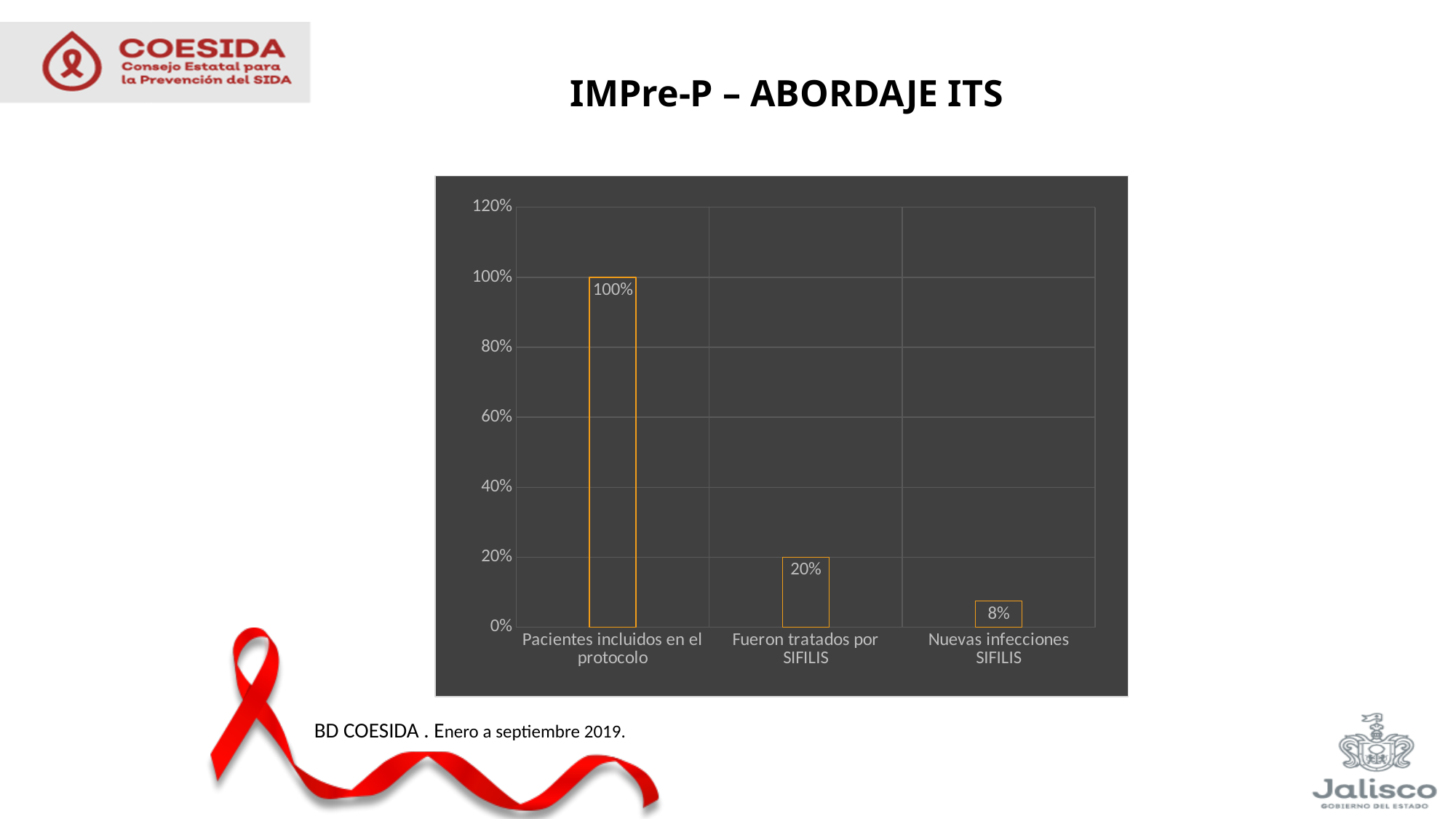
How many categories are shown on the x axis of the chart? 3 What is the value for "Nuevas infecciones SIFILIS"? 8% Which category has the highest value? Pacientes incluidos en el protocolo What is the value for "Fueron tratados por SIFILIS"? 20% What kind of chart is shown on the slide? bar chart What is the difference between the values for "Pacientes incluidos en el protocolo" and "Fueron tratados por SIFILIS"? 80% Do the values rise or fall from left to right along the x axis? fall Which is larger, the value for "Fueron tratados por SIFILIS" or the value for "Nuevas infecciones SIFILIS"? Fueron tratados por SIFILIS What is the value for "Pacientes incluidos en el protocolo"? 100% Is the value for "Nuevas infecciones SIFILIS" greater or less than 20%? less What is the difference between the values for "Fueron tratados por SIFILIS" and "Nuevas infecciones SIFILIS"? 12% Which category has the lowest value? Nuevas infecciones SIFILIS